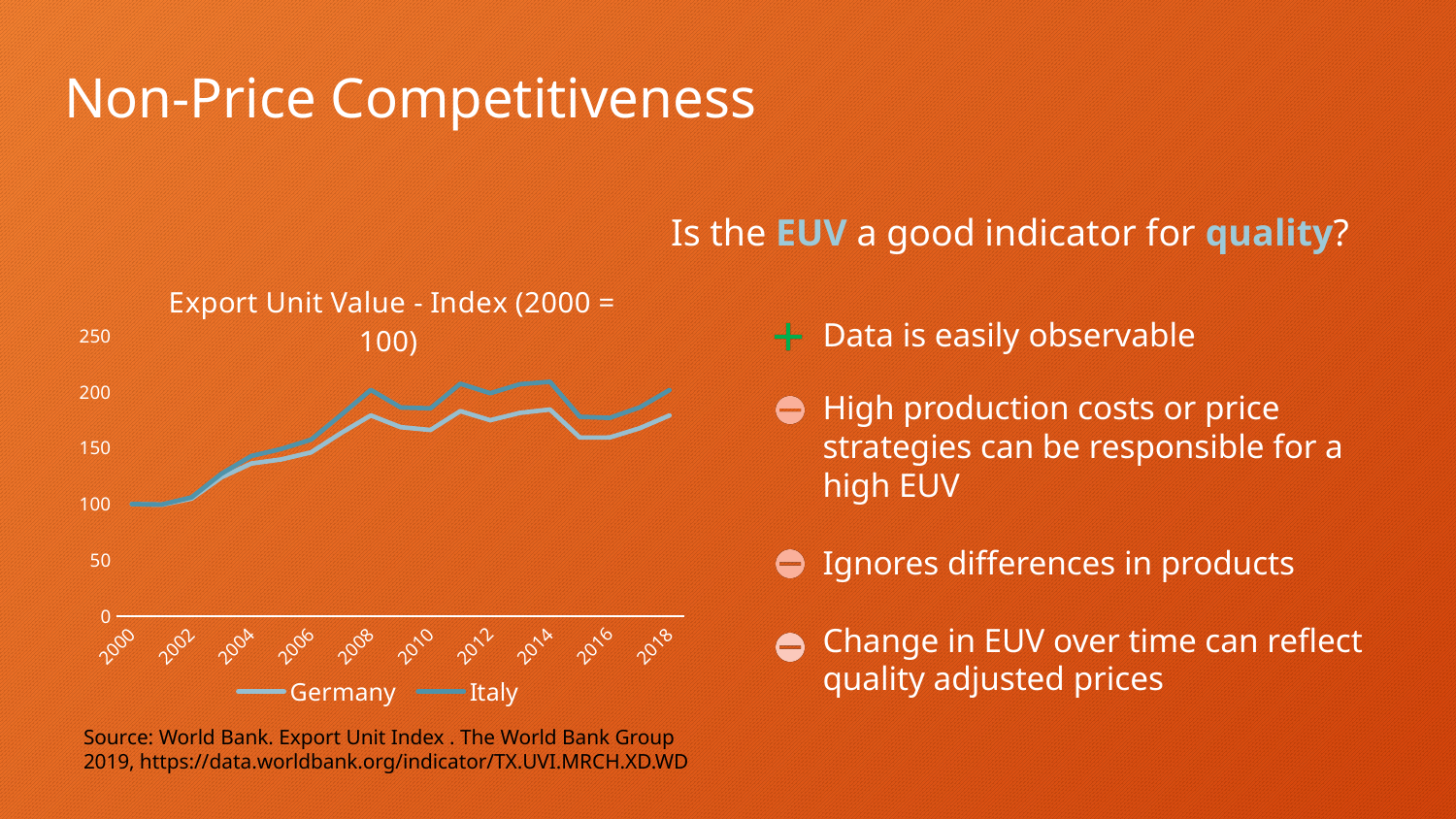
Do the values for Germany generally rise or fall from 2000 to 2018? rise What is the value for Germany in 2000? 100 Which two countries are shown in the chart's legend? Germany and Italy Is the value for Germany in 2018 greater or less than 150? greater Is the value for Italy in 2002 greater or less than 150? less How many series does the chart's legend list? 2 How many year labels are shown on the x axis? 10 What is the title of the chart? Export Unit Value - Index (2000 = 100) Is the value for Italy in 2018 greater or less than 250? less What kind of chart is shown on the slide? line chart What is the value for Italy in 2000? 100